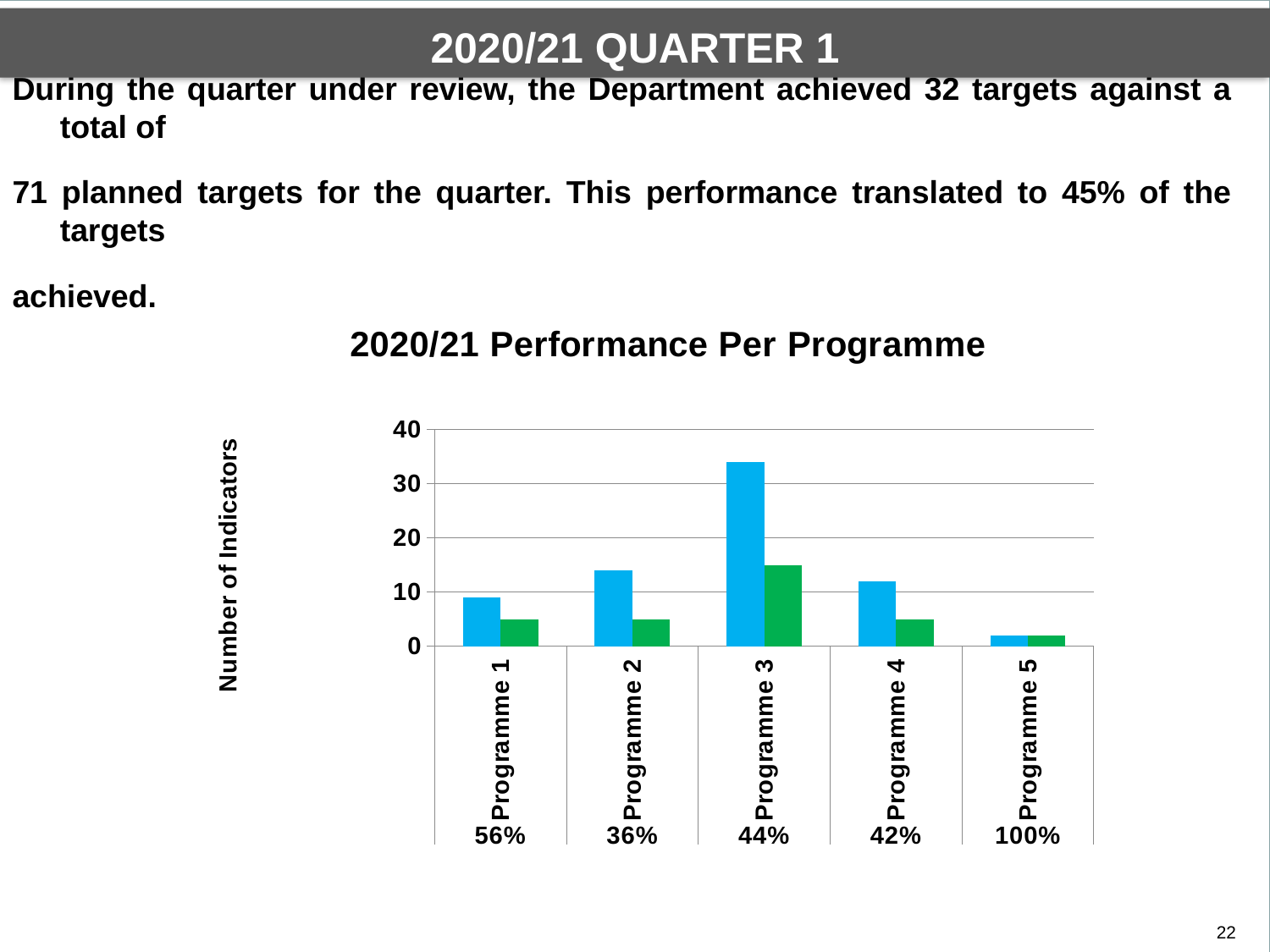
Which programme has the shortest blue bar? Programme 5 Is the blue bar for Programme 2 greater or less than 20? less What is the label of the vertical axis? Number of Indicators What percentage is printed under Programme 2? 36% Which is larger, the blue bar for Programme 1 or the blue bar for Programme 3? Programme 3 What is the title of the chart? 2020/21 Performance Per Programme Is the blue bar for Programme 3 greater or less than 30? greater What percentage is printed under Programme 5? 100% What kind of chart is shown on the slide? Bar chart Is the green bar for Programme 3 greater or less than 20? less Which programme has the tallest blue bar? Programme 3 How many programmes are shown on the x axis of the chart? 5